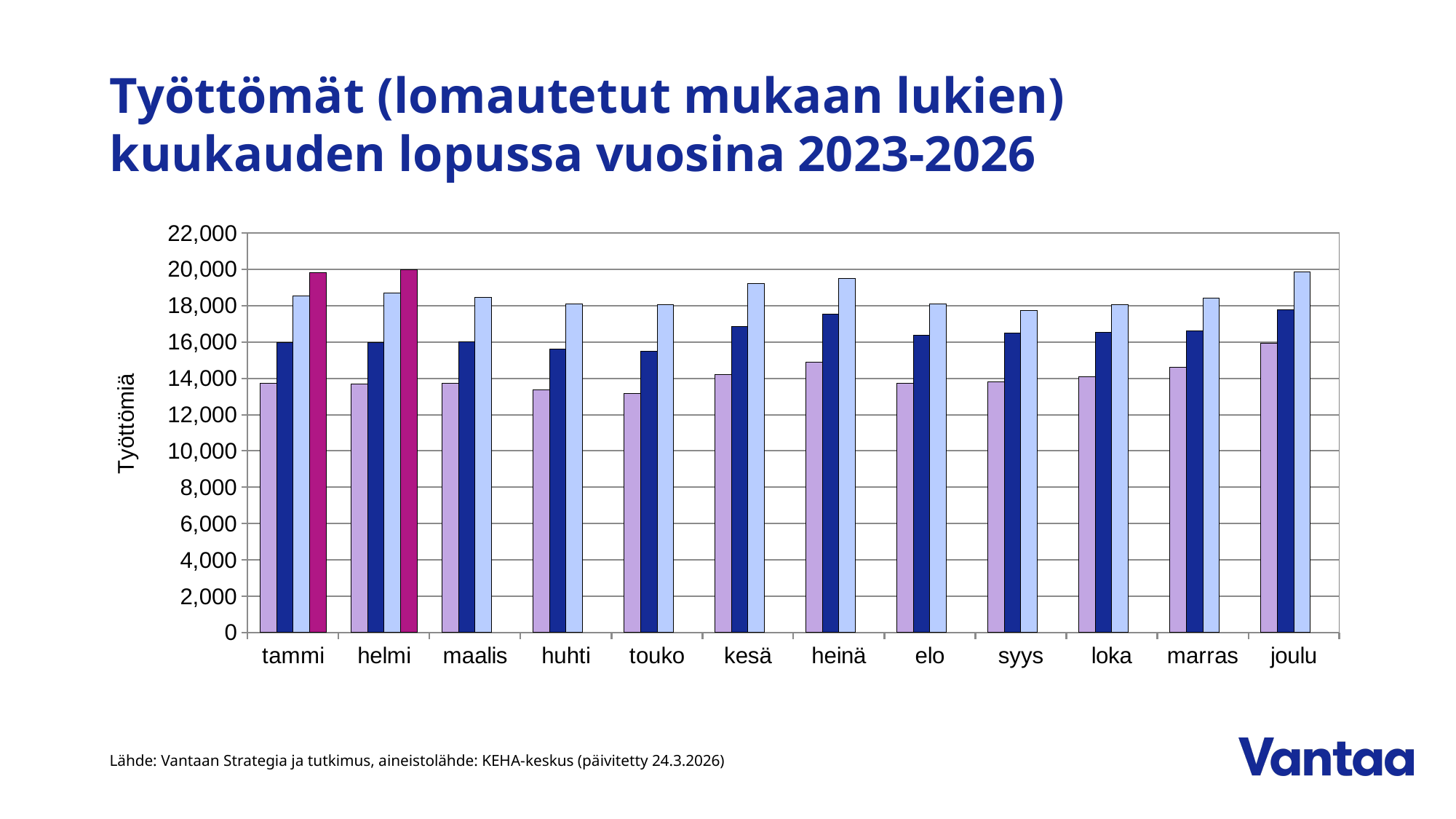
Is the value of the magenta bar for tammi greater or less than 18,000? greater What is the label on the vertical axis of the chart? Työttömiä Is the value of the light blue bar for joulu greater or less than 18,000? greater How many month categories are shown on the x axis? 12 What kind of chart is shown on the slide? bar chart How many bars are plotted for the month tammi? 4 Which month has the highest light purple bar? joulu Is the value of the dark blue bar for heinä greater or less than 16,000? greater How many bars are plotted for the month maalis? 3 Do the dark blue bars rise or fall from touko to heinä? rise For tammi, which is larger: the magenta bar or the light purple bar? the magenta bar